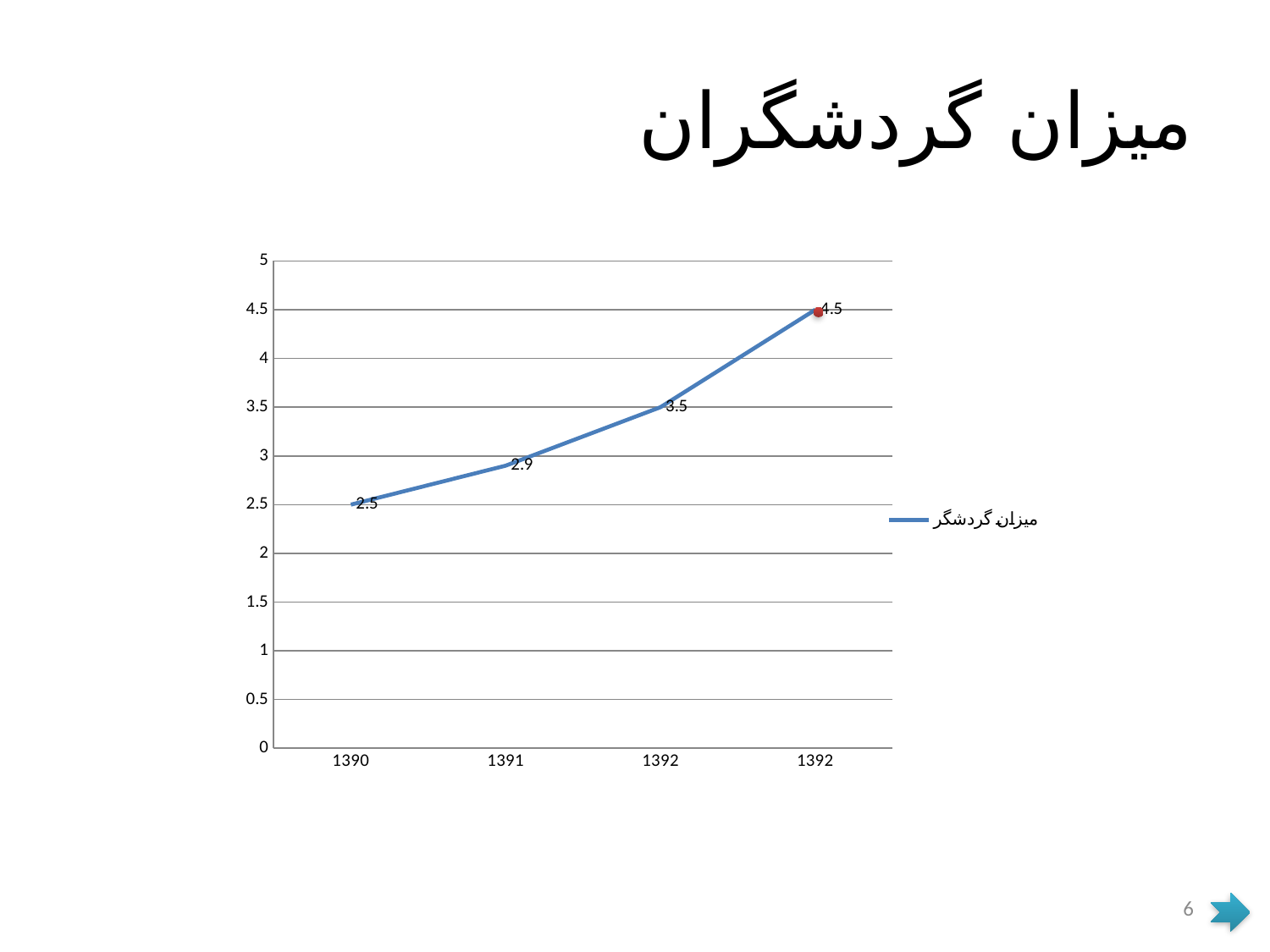
What is the value plotted for 1391? 2.9 Which x-axis category has the lowest value? 1390 Which is larger, the value for 1391 or the value for 1390? 1391 How many data points are plotted on the line? 4 What is the value of the last (rightmost) point on the line? 4.5 What is the value plotted for 1390? 2.5 What type of chart is shown on the slide? line chart What is the difference between the last point (4.5) and the first point (2.5)? 2 Do the values rise or fall from left to right along the x axis? rise What is the highest value plotted on the line? 4.5 What is the difference between the value for 1391 and the value for 1390? 0.4 What is the value of the third point from the left on the line? 3.5